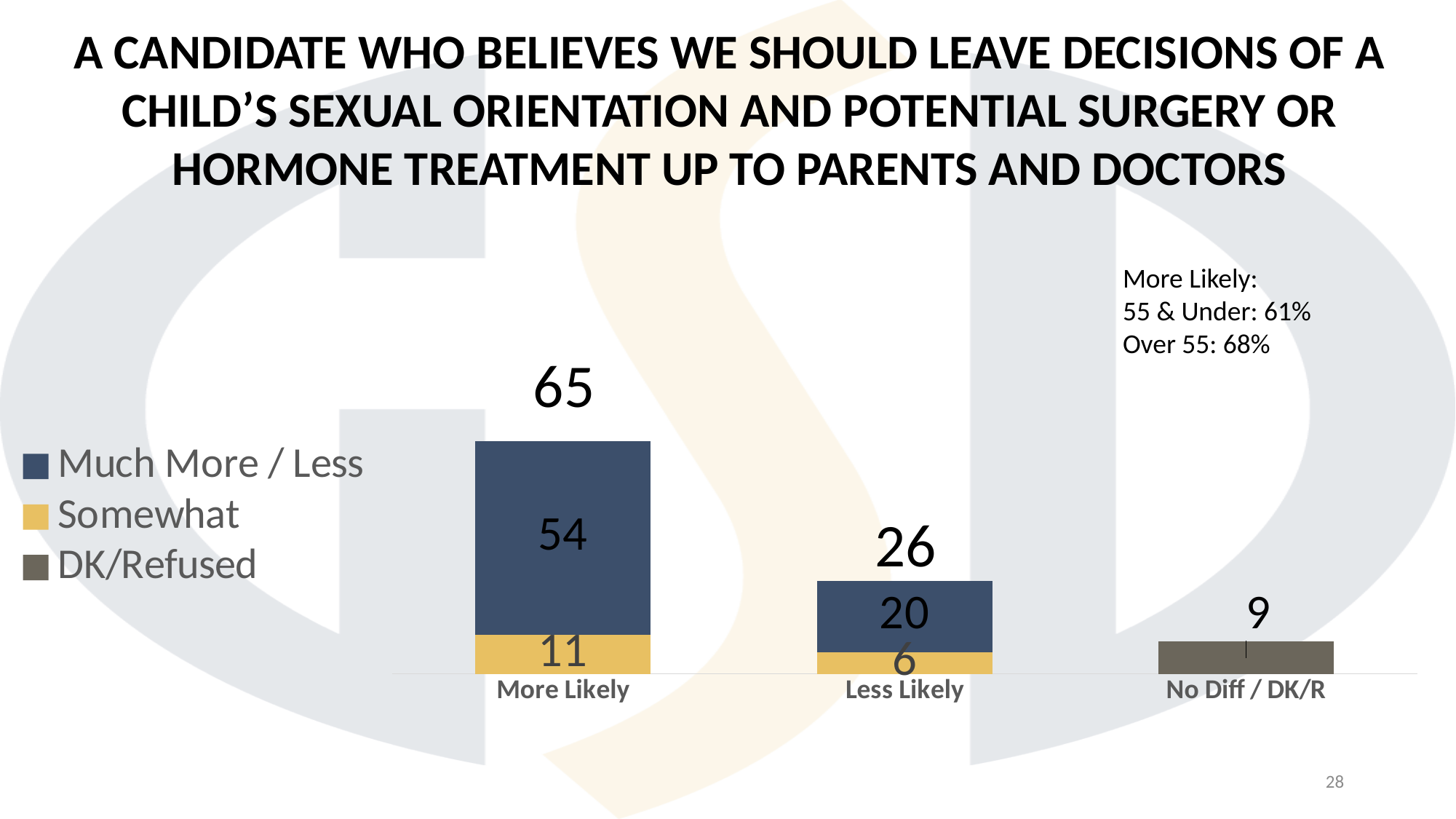
How many categories are shown on the x axis? 3 What is the total shown above the Less Likely stacked bar? 26 What is the value shown for the No Diff / DK/R bar? 9 Which is larger: the 'Somewhat' value for More Likely or the 'Somewhat' value for Less Likely? More Likely What is the 'Much More / Less' value for the More Likely bar? 54 What is the total shown above the More Likely stacked bar? 65 Which category has the lowest total? No Diff / DK/R What is the 'Somewhat' value for the Less Likely bar? 6 What is the difference between the More Likely total and the Less Likely total? 39 Which category has the highest total? More Likely How many series does the legend list? 3 What kind of chart is shown on the slide? Stacked bar chart